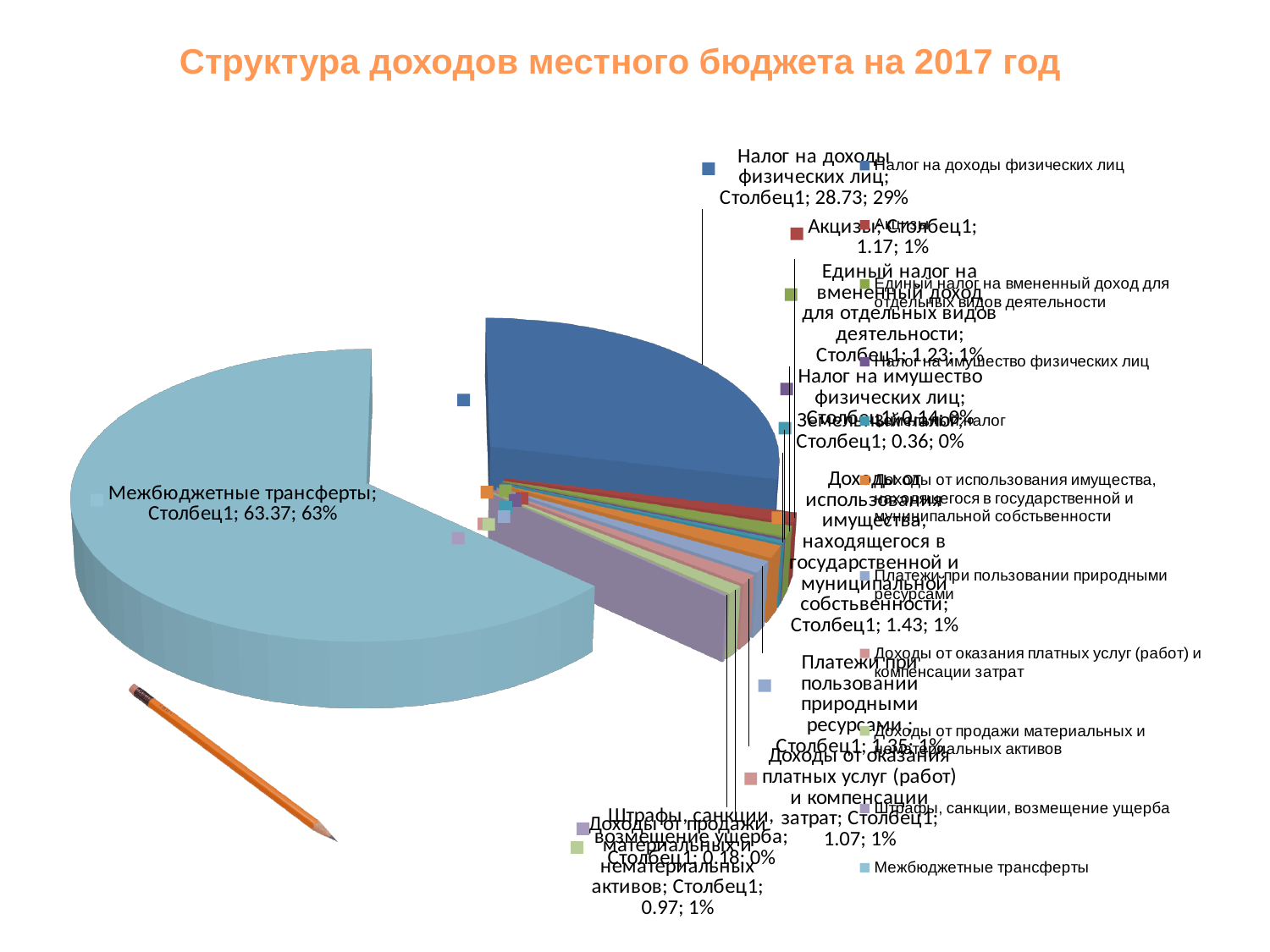
What is the difference between the values for Межбюджетные трансферты and Налог на доходы физических лиц? 34.64 What percentage share does the slice for Межбюджетные трансферты have? 63% What percentage share does the slice for Налог на доходы физических лиц have? 29% What kind of chart is shown on the slide? pie chart What value is printed for Налог на доходы физических лиц? 28.73 Which category has the largest slice of the pie? Межбюджетные трансферты How many categories does the legend list? 11 Which is larger: the value for Акцизы or the value for Единый налог на вмененный доход для отдельных видов деятельности? Единый налог на вмененный доход для отдельных видов деятельности What value is printed for Штрафы, санкции, возмещение ущерба? 0.18 What is the title of the chart? Структура доходов местного бюджета на 2017 год What value is printed for Межбюджетные трансферты? 63.37 What value is printed for Земельный налог? 0.36